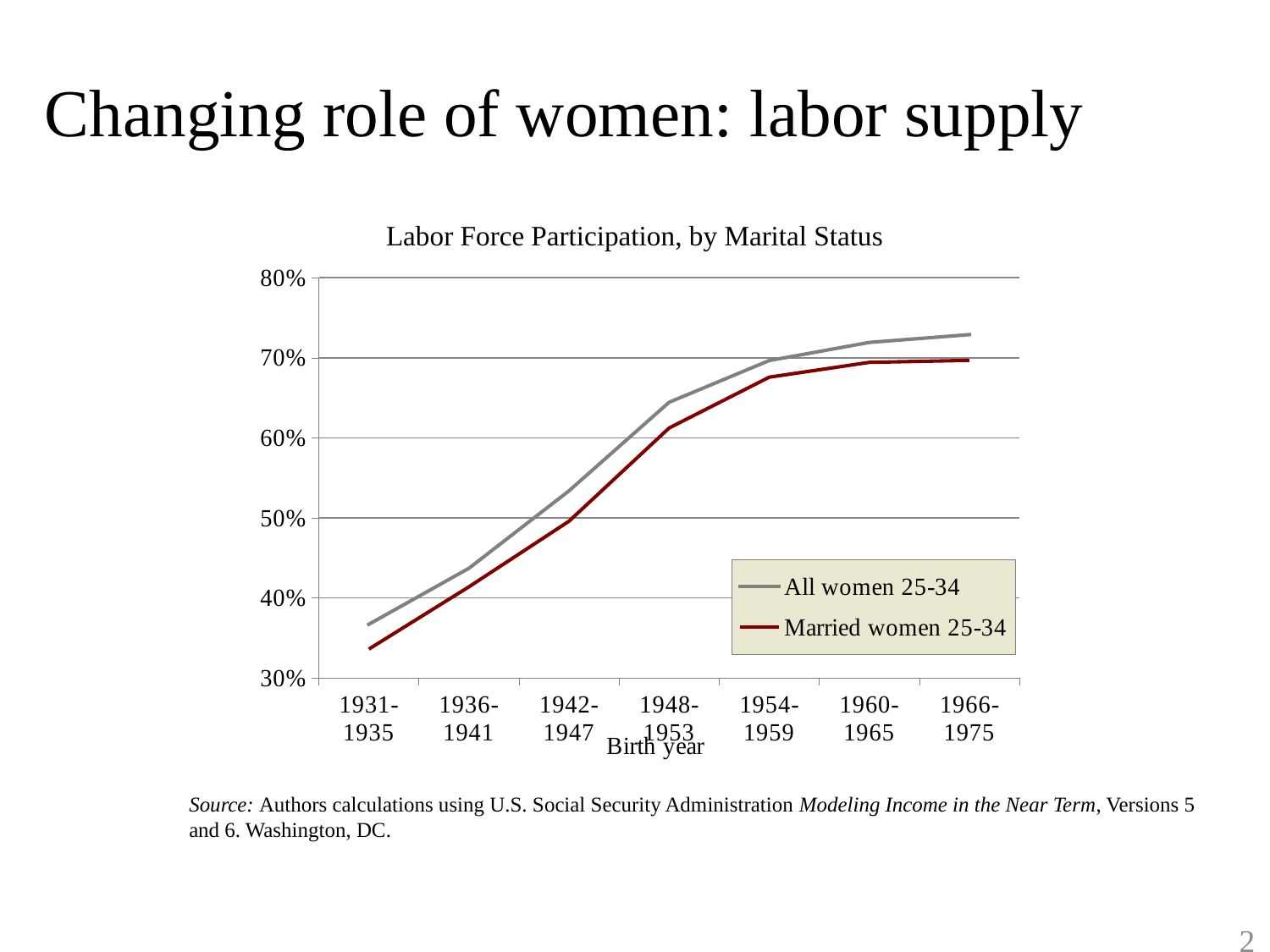
For the 1931-1935 cohort, which series has the larger value: All women 25-34 or Married women 25-34? All women 25-34 Is the value for Married women 25-34 in the 1954-1959 cohort greater or less than 70%? less How many birth-year cohorts are shown on the x axis? 7 What is the title of the chart? Labor Force Participation, by Marital Status How many series does the legend list? 2 Is the value for All women 25-34 in the 1931-1935 cohort greater or less than 40%? less Do the labor force participation values rise or fall across birth years? rise Is the value for All women 25-34 in the 1966-1975 cohort greater or less than 70%? greater What kind of chart is shown on the slide? line chart Which birth-year cohort has the lowest labor force participation for Married women 25-34? 1931-1935 Which birth-year cohort has the highest labor force participation for All women 25-34? 1966-1975